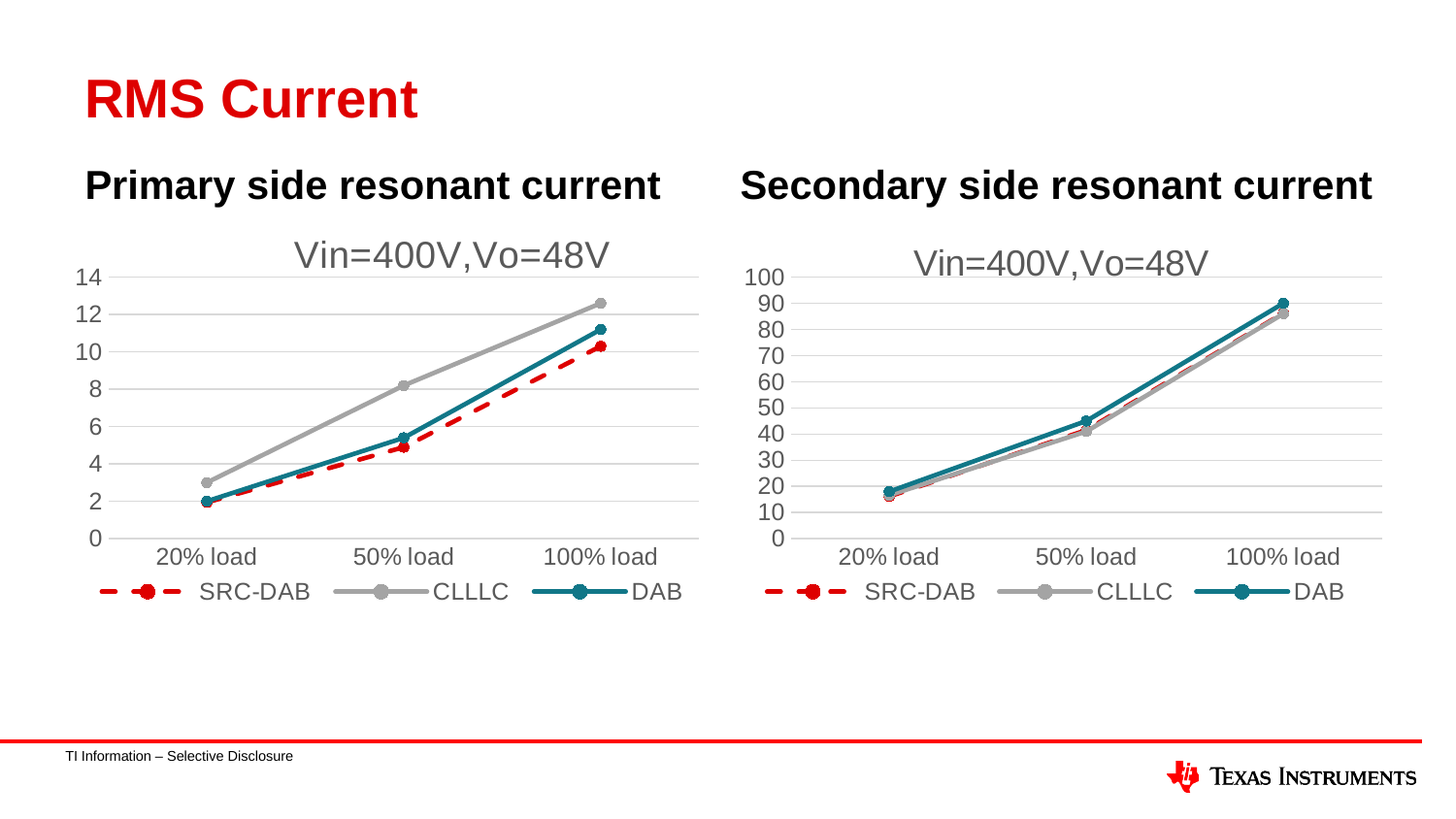
In the Primary side resonant current chart, is the CLLLC value at 100% load greater or less than 12? greater What kind of chart is the Primary side resonant current chart on the left? line chart In the Primary side resonant current chart, is the CLLLC value at 20% load greater or less than 4? less How many load categories are shown on the x axis of the Primary side resonant current chart? 3 In the Secondary side resonant current chart, is the DAB value at 50% load greater or less than 40? greater In the Primary side resonant current chart, which series has the highest value at 100% load? CLLLC What is the title shown above the plot area of the Secondary side resonant current chart? Vin=400V,Vo=48V In the Secondary side resonant current chart, do the values rise or fall as load increases from 20% to 100%? rise How many series does the legend of the Secondary side resonant current chart list? 3 In the Primary side resonant current chart, which is larger at 50% load, CLLLC or SRC-DAB? CLLLC